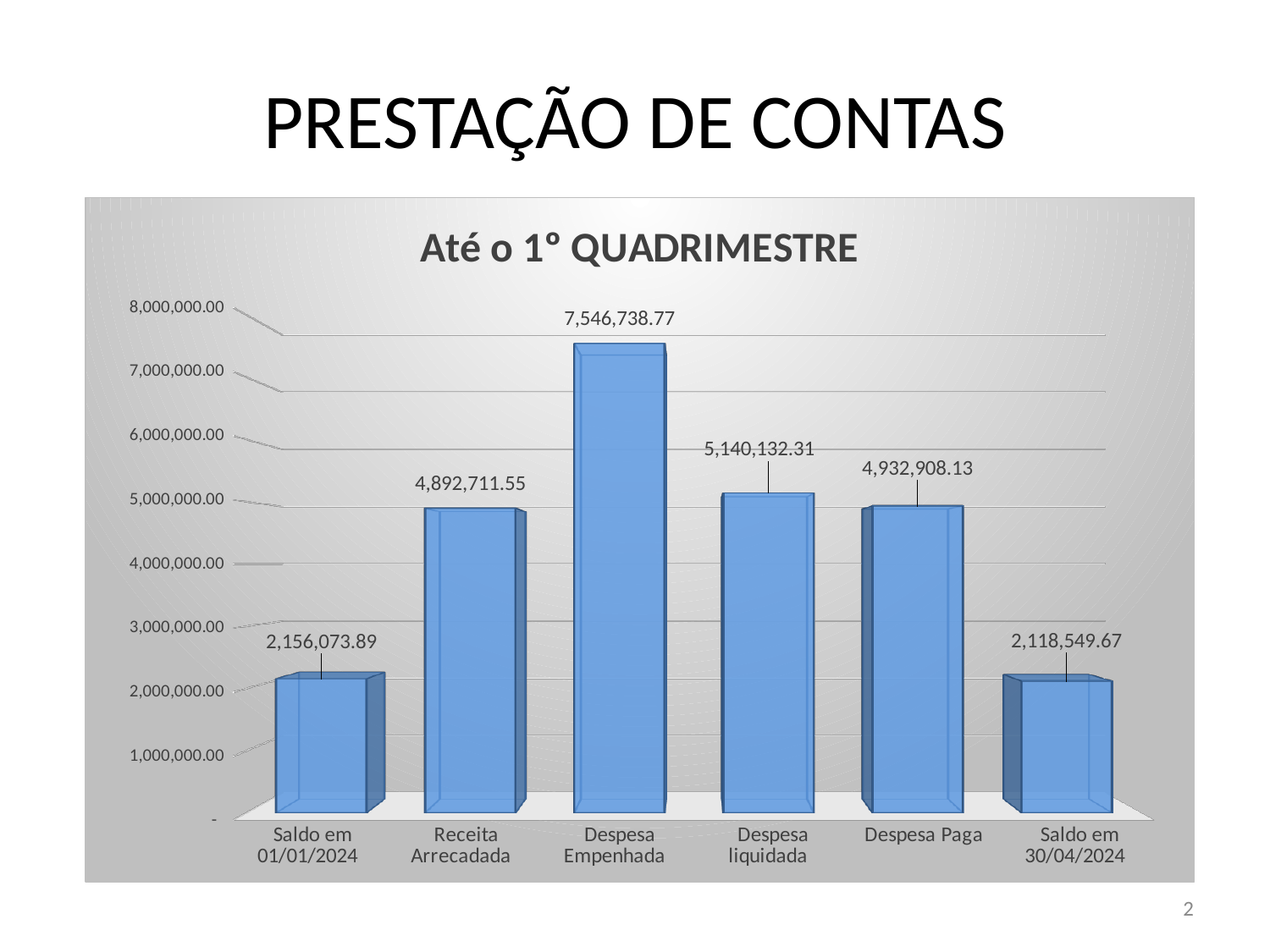
What is the value for Receita Arrecadada? 4,892,711.55 Is the value for Despesa Paga greater or less than 4,000,000.00? greater Which category has the highest value? Despesa Empenhada What is the title of the chart? Até o 1º QUADRIMESTRE What is the value for Despesa Empenhada? 7,546,738.77 What is the difference between Despesa Empenhada and Despesa liquidada? 2,406,606.46 What is the difference between Saldo em 01/01/2024 and Saldo em 30/04/2024? 37,524.22 What is the value for Saldo em 30/04/2024? 2,118,549.67 How many categories are shown in the chart? 6 Which category has the lowest value? Saldo em 30/04/2024 What is the value for Despesa liquidada? 5,140,132.31 Which is larger, Despesa Paga or Receita Arrecadada? Despesa Paga